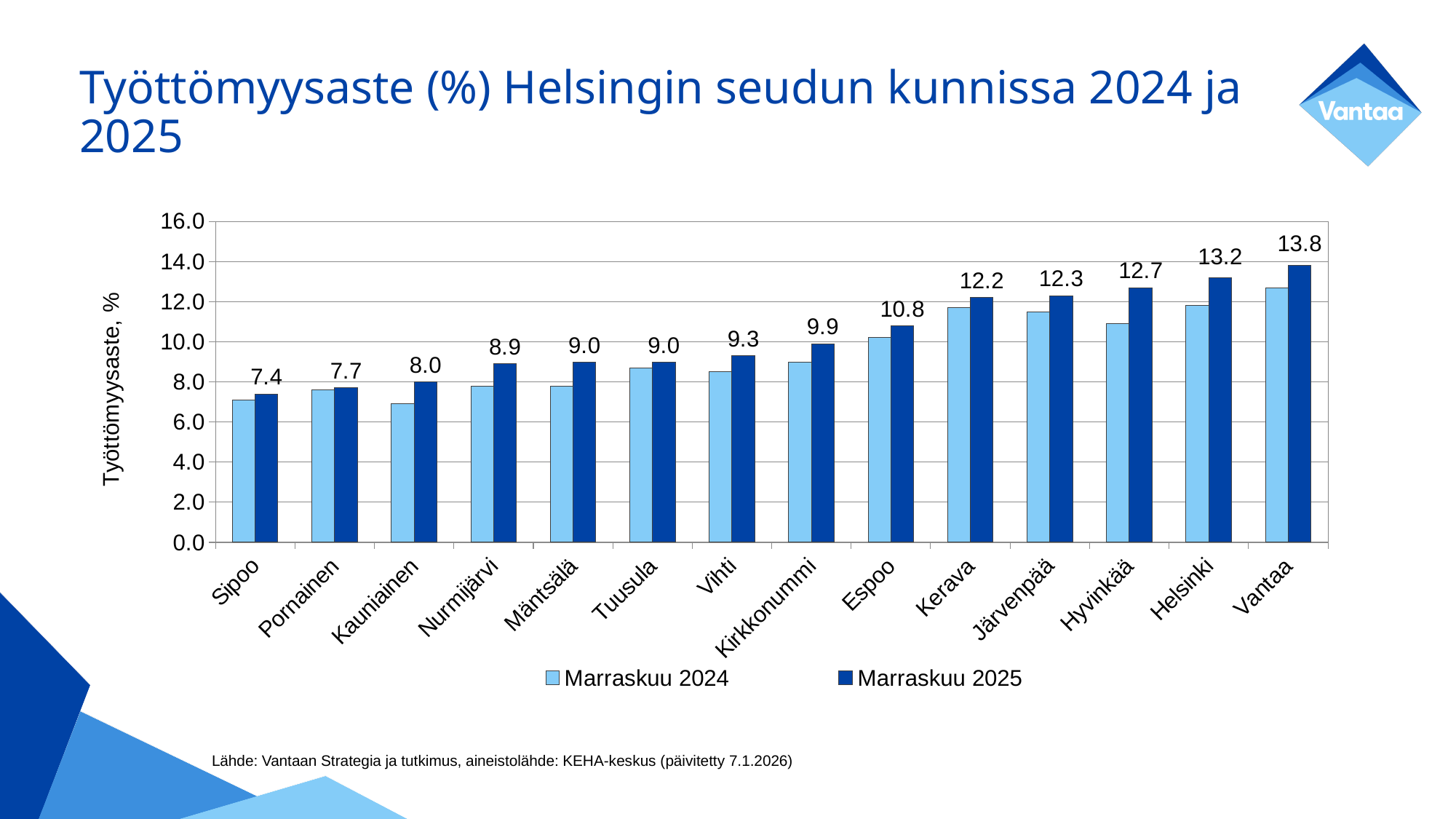
Do the Marraskuu 2025 values rise or fall from left to right along the x axis? rise What is the difference between the Marraskuu 2025 values for Vantaa and Helsinki? 0.6 What kind of chart is shown on the slide? bar chart Is the Marraskuu 2024 value for Helsinki greater or less than 10.0? greater Which municipality has the highest Marraskuu 2025 unemployment rate? Vantaa What is the Marraskuu 2025 value for Espoo? 10.8 What is the unemployment rate for Vantaa in Marraskuu 2025? 13.8 What is the Marraskuu 2025 value for Sipoo? 7.4 How many series does the legend list? 2 Which municipality has the lowest Marraskuu 2025 unemployment rate? Sipoo Which has the larger Marraskuu 2025 value, Hyvinkää or Järvenpää? Hyvinkää How many municipalities are shown on the x axis? 14